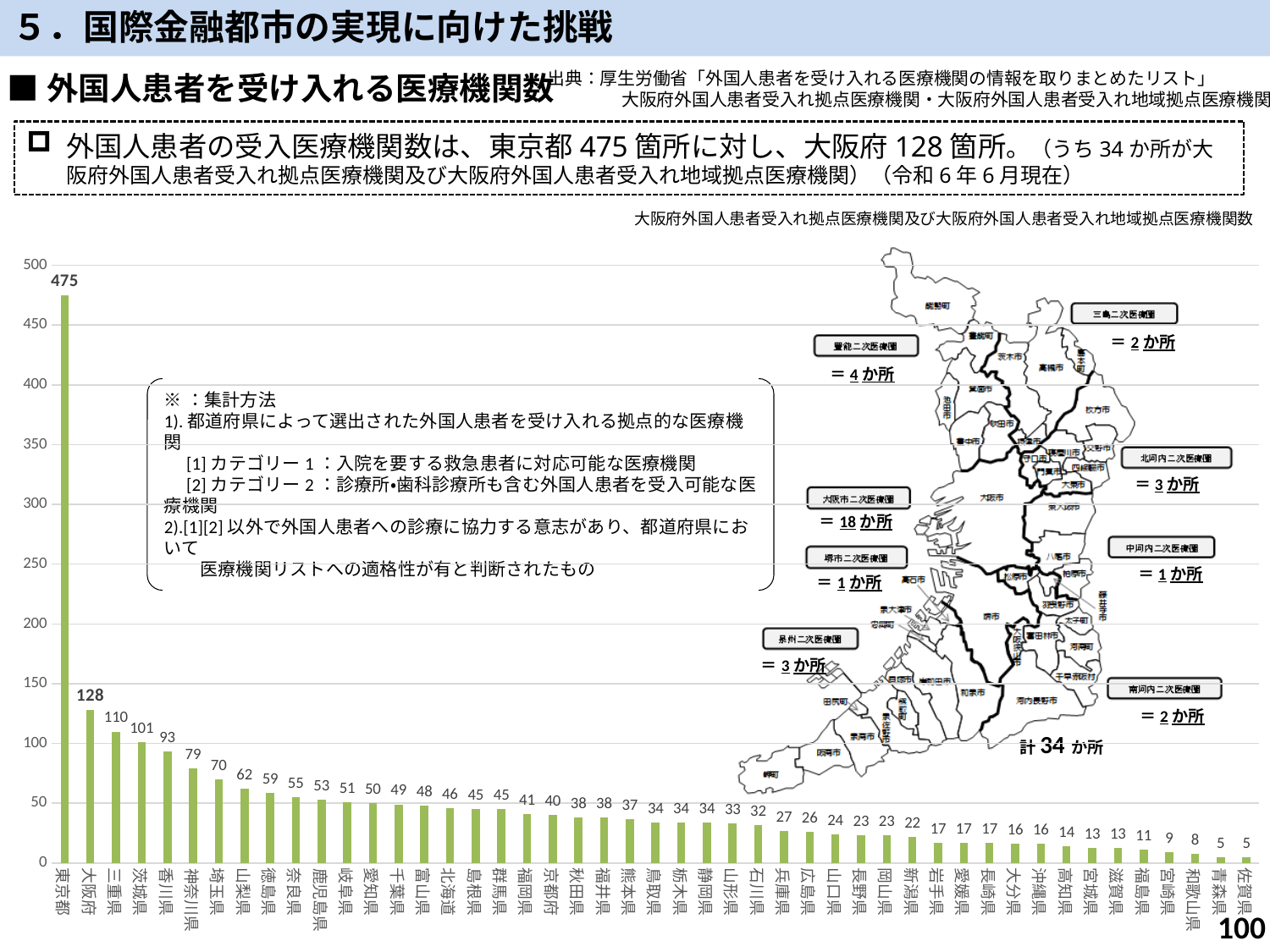
What is the value for 北海道 in the bar chart? 46 Which prefecture has the highest value in the bar chart? 東京都 What is the difference between the values for 東京都 and 大阪府? 347 Which has a larger value, 愛知県 or 兵庫県? 愛知県 What kind of chart is used to show the number of medical institutions by prefecture? bar chart Which has a larger value, 福岡県 or 京都府? 福岡県 What is the value for 大阪府 in the bar chart? 128 What is the value for 東京都 in the bar chart? 475 How many prefectures are shown on the x axis of the bar chart? 47 What is the value for 神奈川県 in the bar chart? 79 Is the value for 埼玉県 greater or less than 50? greater What is the difference between the values for 三重県 and 茨城県? 9